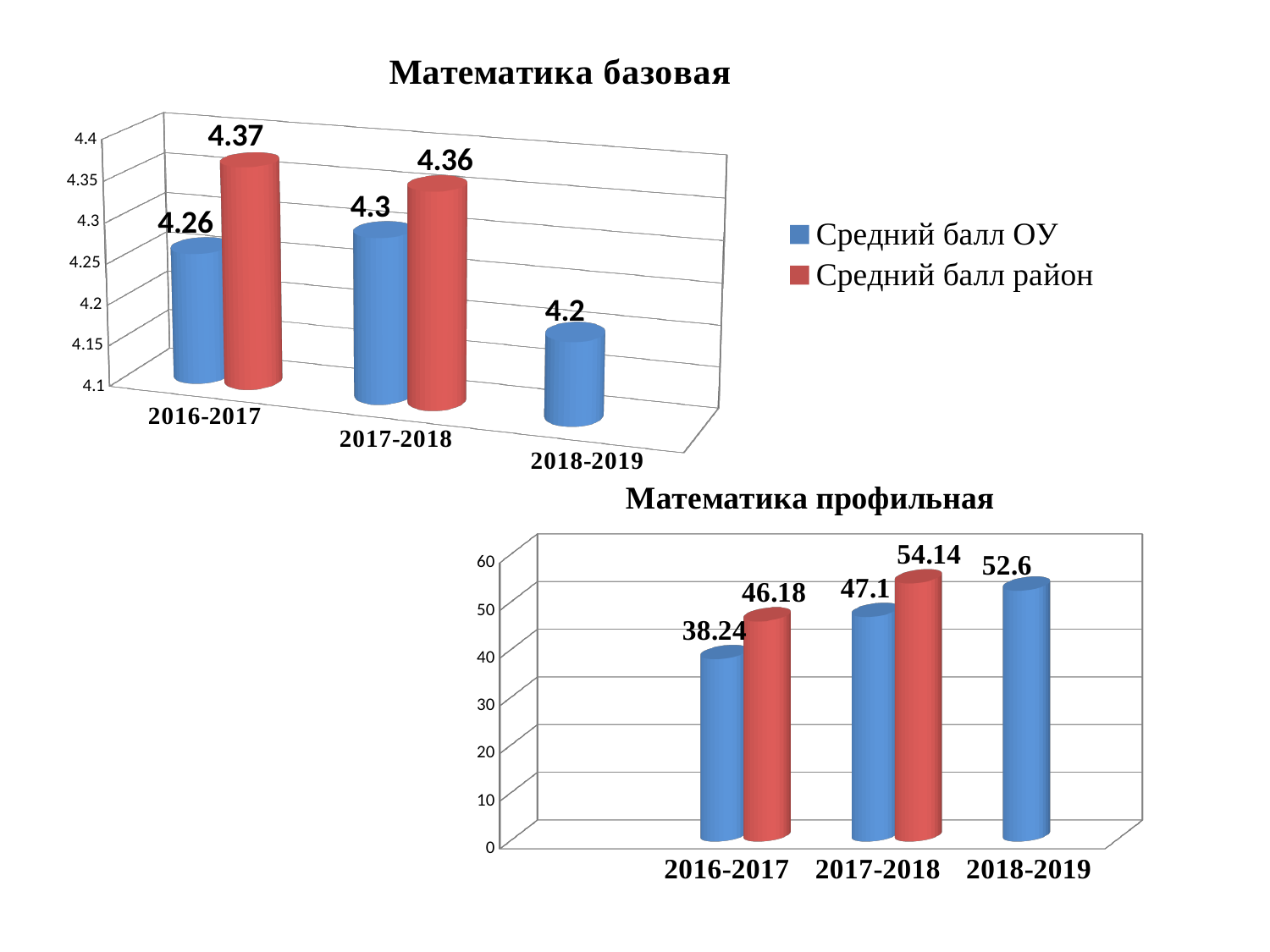
In the chart titled "Математика базовая", what is the difference between Средний балл район and Средний балл ОУ for 2016-2017? 0.11 How many series does the legend on the slide list? 2 In the chart titled "Математика профильная", what is the value of Средний балл район for 2016-2017? 46.18 In the chart titled "Математика базовая", which year has the lowest value for Средний балл ОУ? 2018-2019 In the chart titled "Математика профильная", which is larger for 2016-2017: Средний балл ОУ or Средний балл район? Средний балл район In the chart titled "Математика профильная", what is the difference between Средний балл район and Средний балл ОУ for 2017-2018? 7.04 In the chart titled "Математика базовая", what is the value of Средний балл ОУ for 2016-2017? 4.26 In the chart titled "Математика профильная", which year has the highest value for Средний балл ОУ? 2018-2019 In the chart titled "Математика базовая", what is the value of Средний балл район for 2017-2018? 4.36 In the chart titled "Математика базовая", does the value for Средний балл ОУ rise or fall from 2017-2018 to 2018-2019? fall What kind of chart is the chart titled "Математика профильная"? bar chart In the chart titled "Математика профильная", what is the value of Средний балл ОУ for 2018-2019? 52.6